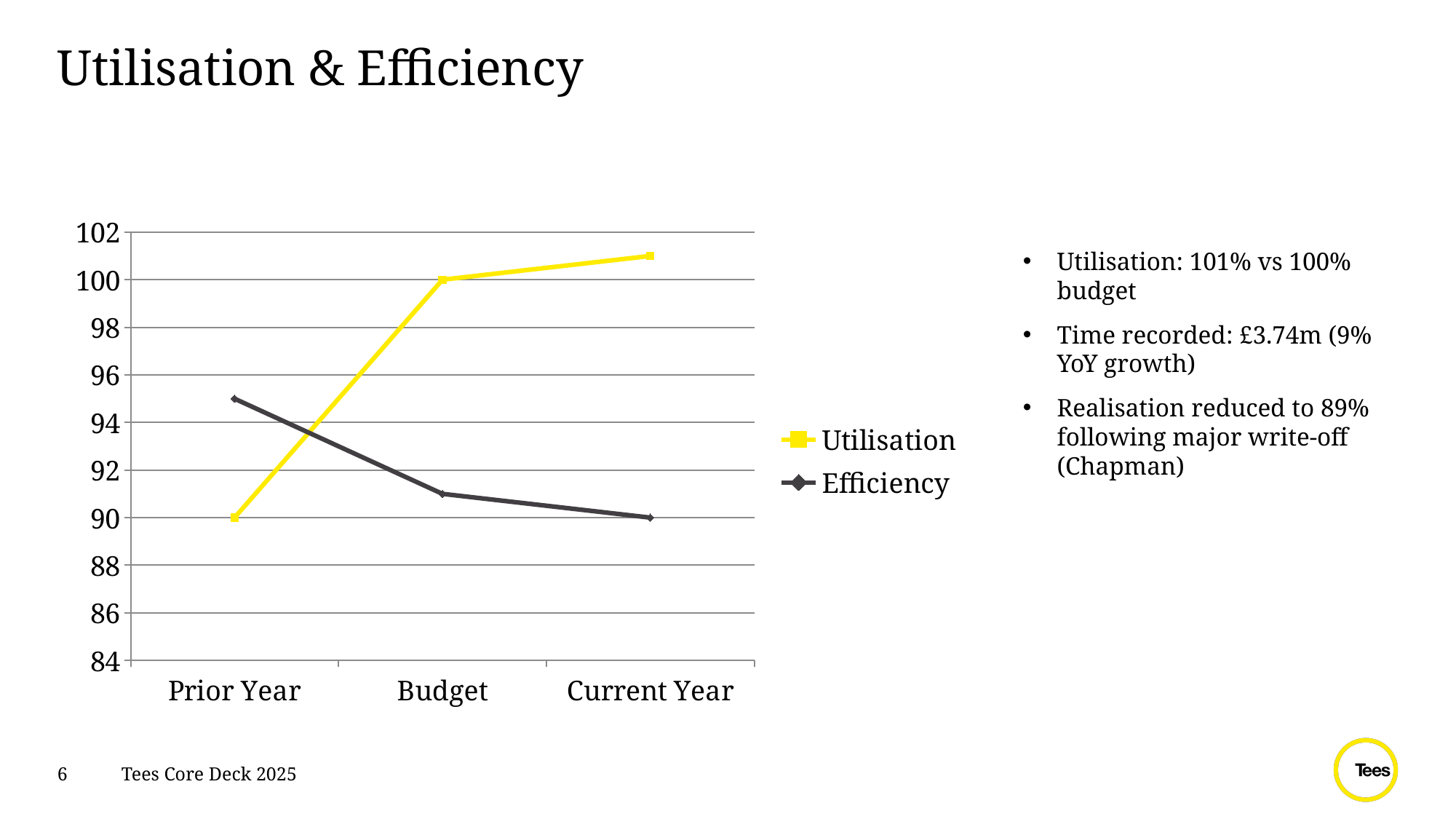
How many categories are shown on the x axis of the chart? 3 Is the Utilisation value for Current Year greater or less than 100? greater Which series has the higher value for Prior Year, Utilisation or Efficiency? Efficiency What is the Efficiency value for Current Year? 90 What type of chart is shown on the slide? Line chart What is the difference between the Utilisation values for Budget and Prior Year? 10 For which category is the Efficiency value highest? Prior Year Is the Efficiency value for Prior Year greater or less than 94? greater Does the Efficiency line rise or fall from Prior Year to Current Year? Fall What is the Utilisation value for Prior Year? 90 How many series does the chart legend list? 2 What is the Utilisation value for Budget? 100